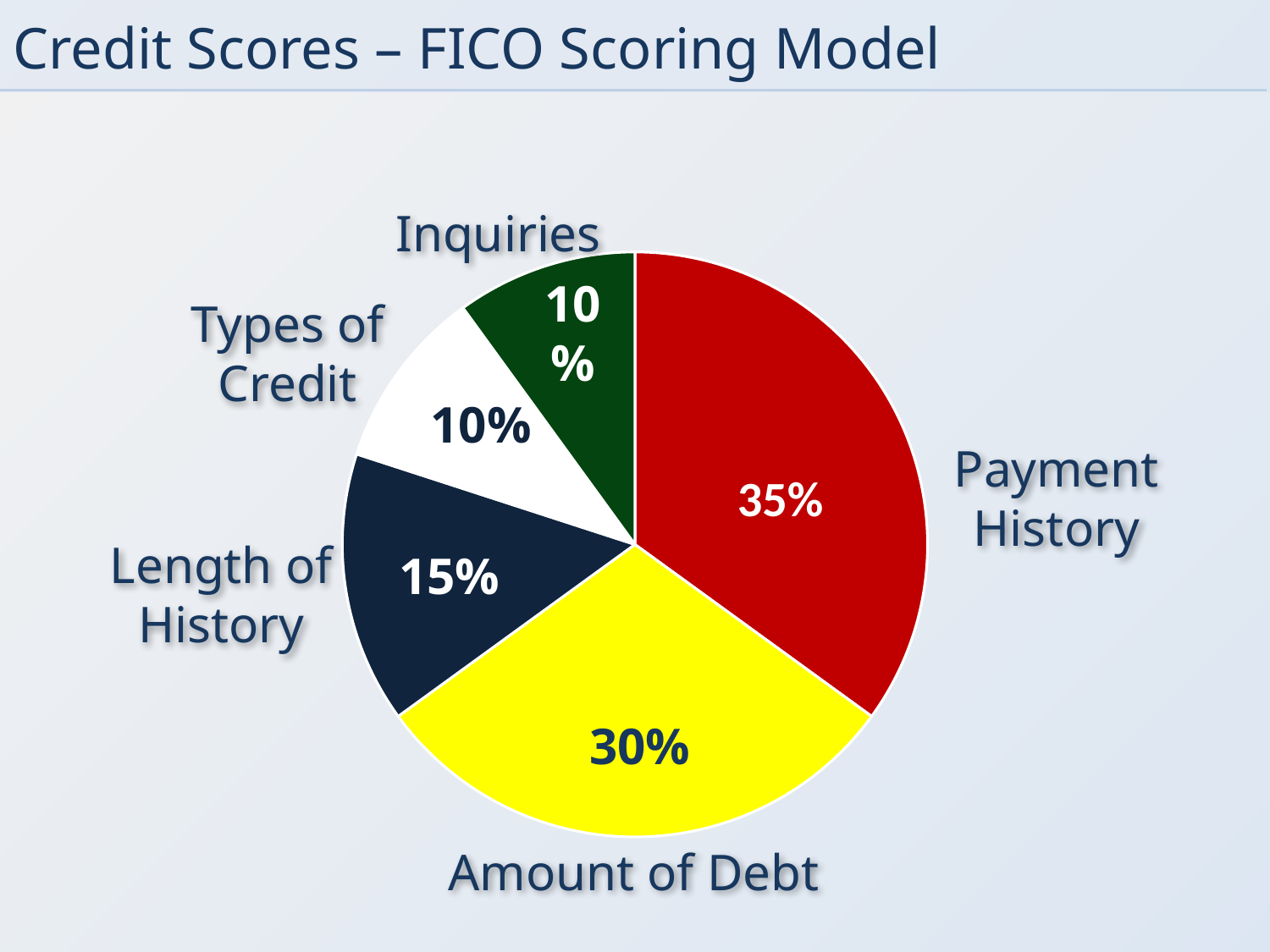
How many slices does the pie chart have? 5 What is the value shown for Inquiries? 10% Which category has the largest slice of the pie? Payment History What is the difference between the Amount of Debt and Length of History values? 15% What is the value shown for Length of History? 15% What kind of chart is shown on the slide? pie chart What share of the pie does Payment History account for? 35% Which is larger, Length of History or Types of Credit? Length of History What is the value shown for Amount of Debt? 30% What is the value shown for Types of Credit? 10% What is the difference between the Payment History and Amount of Debt values? 5% What colour is the Amount of Debt slice? yellow